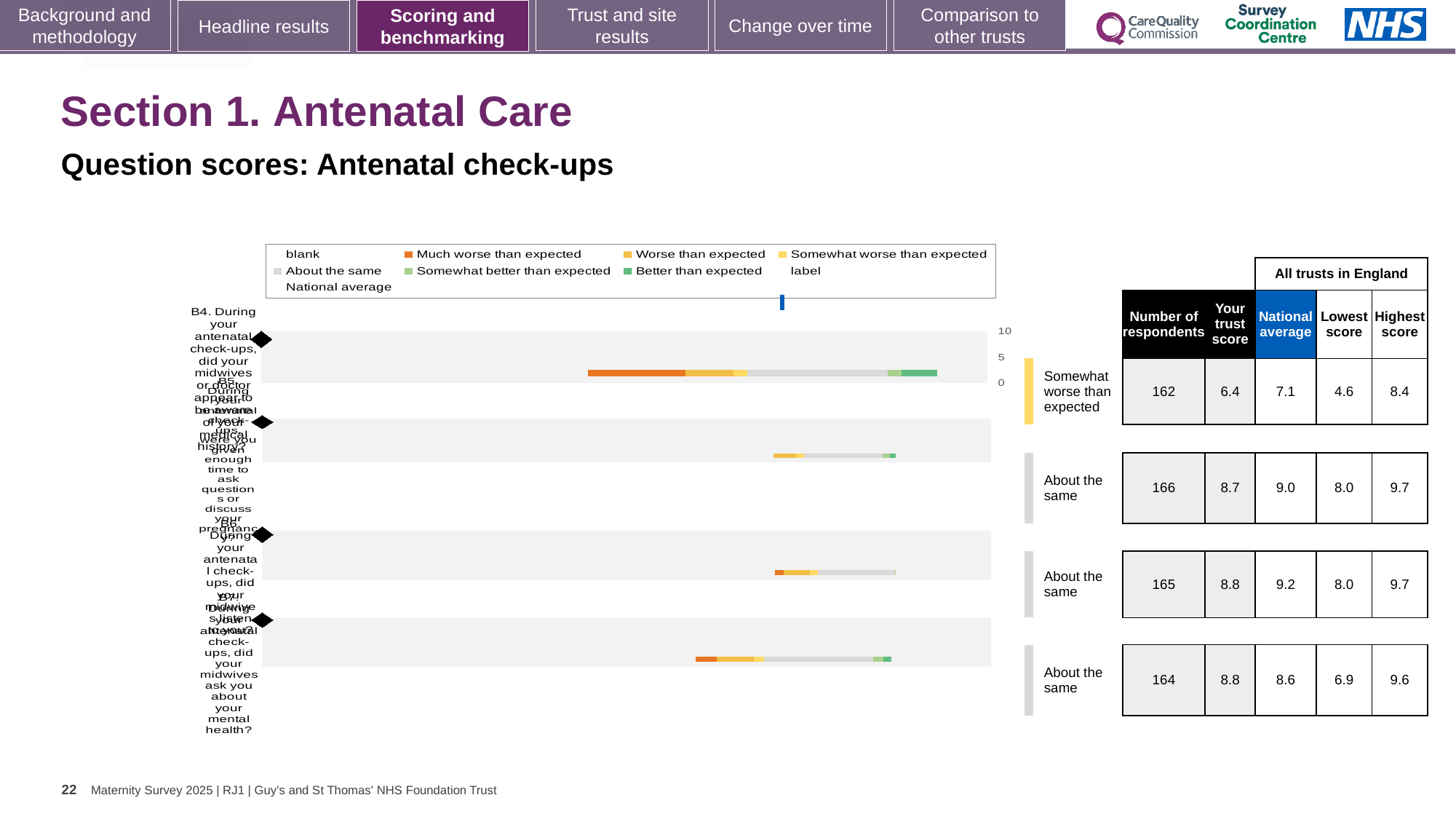
In the table beside the chart, what is the highest score for the fourth row (B7)? 9.6 Which legend entry is shown in orange in the chart? Much worse than expected In the table beside the chart, what is the national average for the second row (B5)? 9.0 In the table beside the chart, what is the trust score for the first row (B4)? 6.4 In the table beside the chart, what is the number of respondents for the first row (B4)? 162 What kind of chart is shown on the slide? bar chart In the table beside the chart, what is the benchmark category for the first row (B4)? Somewhat worse than expected In the table beside the chart, which row has the lowest trust score? B4 (6.4) In the table beside the chart, is the trust score for the fourth row (B7) higher or lower than its national average? higher In the table beside the chart, what is the difference between the national average and the trust score for the first row (B4)? 0.7 What is the title of the slide section above the chart? Question scores: Antenatal check-ups How many question bars (B4 to B7) are plotted in the chart? 4